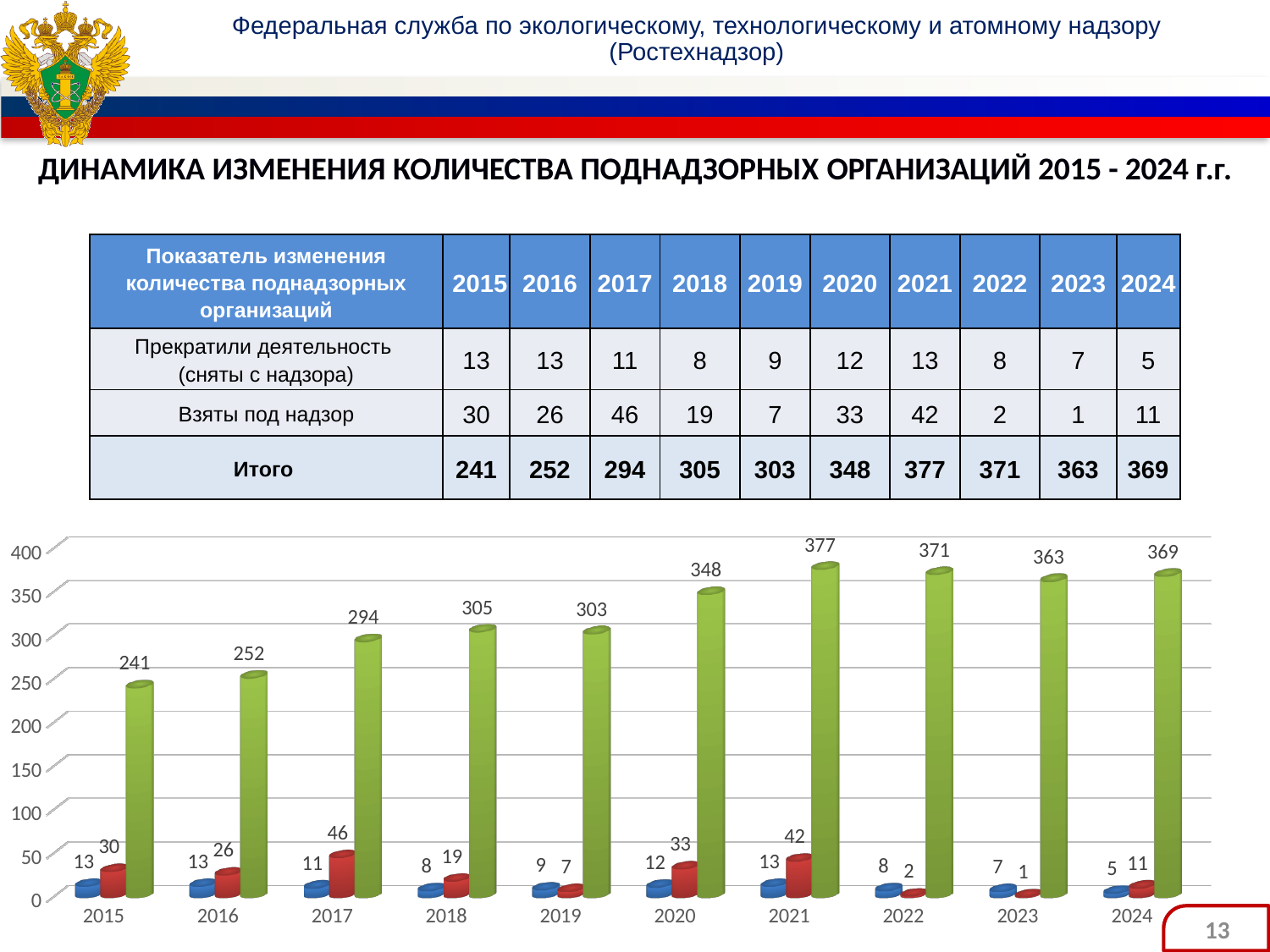
What is the value of the blue bar for 2024? 5 In which year is the green bar the lowest? 2015 Do the green bar values generally rise or fall from 2015 to 2021? rise Is the green bar for 2018 greater or less than 300? greater Which is larger, the red bar for 2020 or the red bar for 2021? 2021 In which year is the red bar the lowest? 2023 What is the value of the red bar for 2017? 46 What type of chart is shown on the slide? bar chart In which year is the green bar the highest? 2021 What is the value of the green bar for 2021? 377 How many years are shown along the x axis of the chart? 10 What is the difference between the green bar values for 2021 and 2015? 136